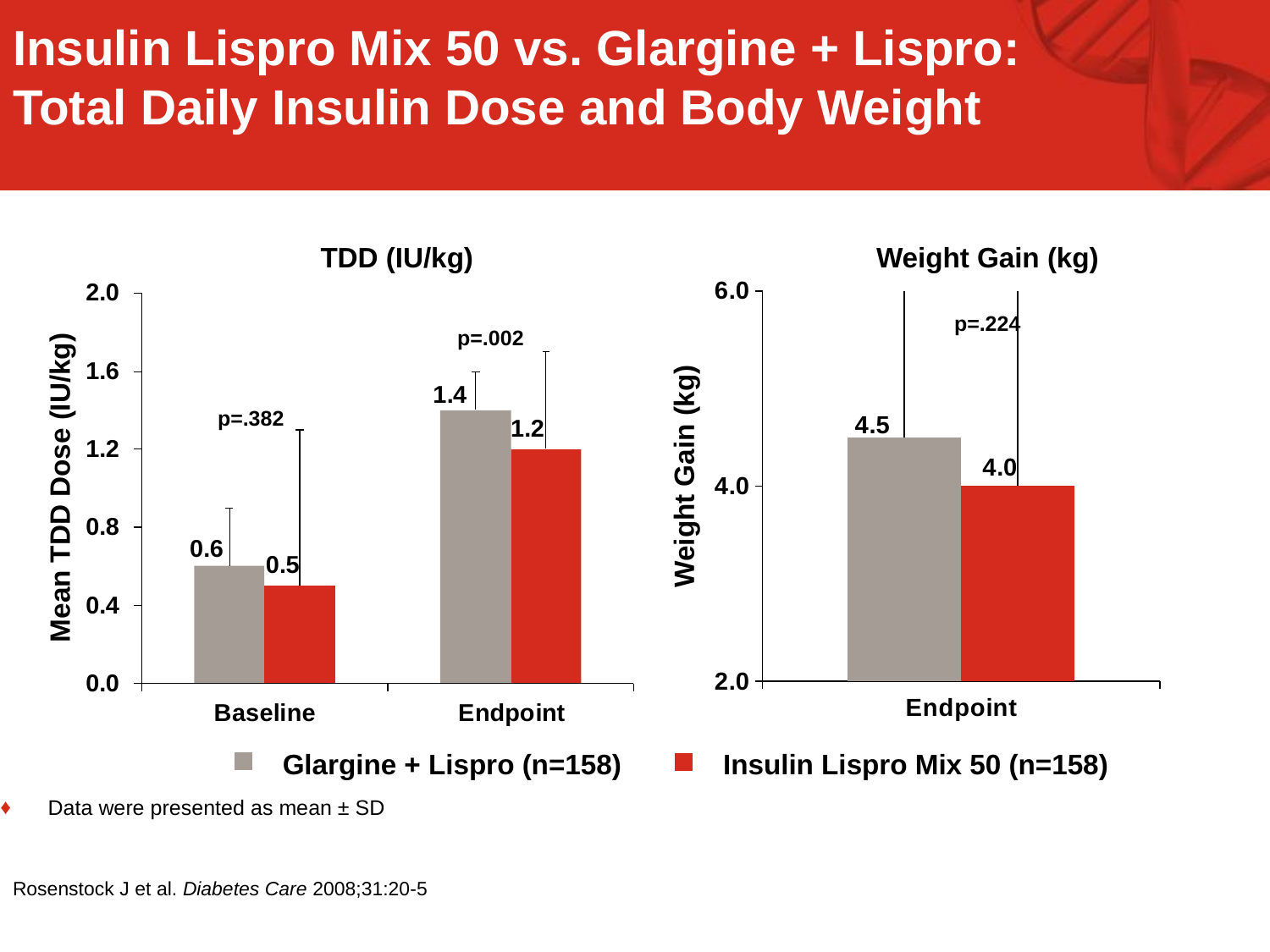
How many series does the legend list? 2 In the TDD (IU/kg) chart, what is the mean TDD dose for Glargine + Lispro at Endpoint? 1.4 What kind of chart is the Weight Gain (kg) chart? bar chart In the Weight Gain (kg) chart, what is the weight gain for Glargine + Lispro at Endpoint? 4.5 In the TDD (IU/kg) chart, what is the difference between the Glargine + Lispro and Insulin Lispro Mix 50 values at Endpoint? 0.2 In the TDD (IU/kg) chart, which series has the higher value at Baseline? Glargine + Lispro (n=158) In the TDD (IU/kg) chart, which bar has the lowest value? Insulin Lispro Mix 50 at Baseline In the TDD (IU/kg) chart, which bar has the highest value? Glargine + Lispro at Endpoint In the TDD (IU/kg) chart, what is the mean TDD dose for Insulin Lispro Mix 50 at Baseline? 0.5 In the TDD (IU/kg) chart, do the values for Insulin Lispro Mix 50 rise or fall from Baseline to Endpoint? rise In the Weight Gain (kg) chart, what is the difference between the Glargine + Lispro and Insulin Lispro Mix 50 values? 0.5 In the Weight Gain (kg) chart, what is the weight gain for Insulin Lispro Mix 50 at Endpoint? 4.0